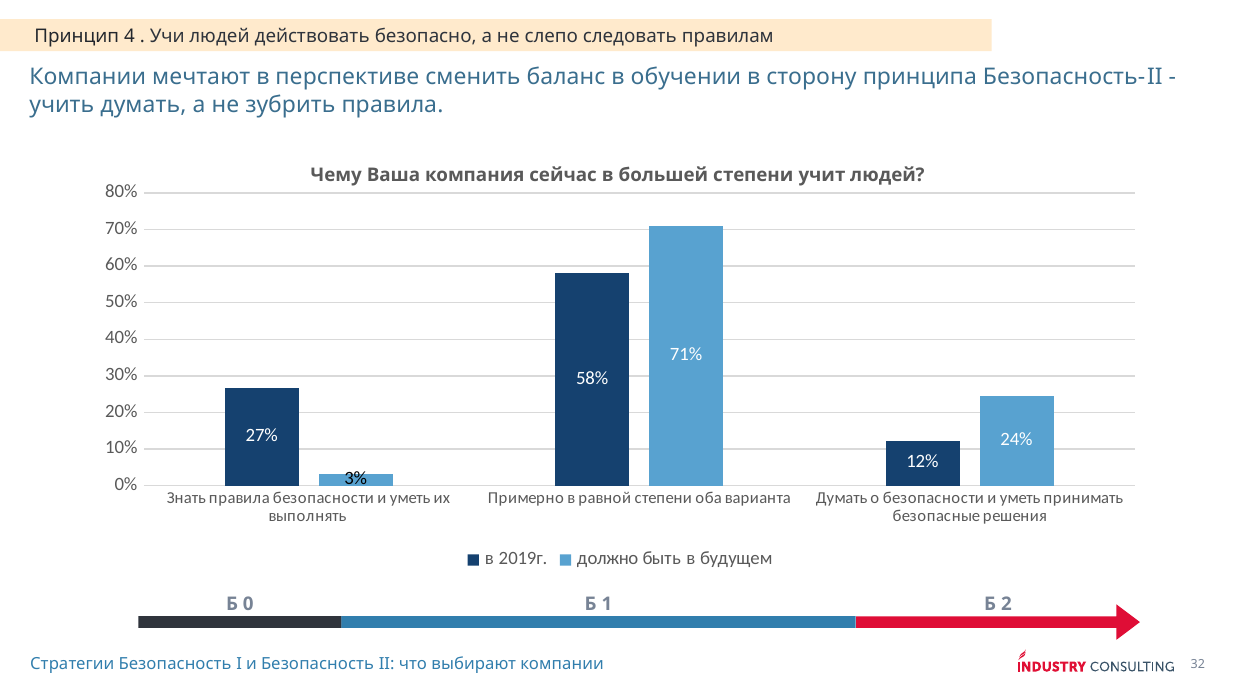
What is the value for 'Знать правила безопасности и уметь их выполнять' in the 'в 2019г.' series? 27% What is the value for 'Знать правила безопасности и уметь их выполнять' in the 'должно быть в будущем' series? 3% How many categories are shown on the x axis? 3 What is the title of the chart? Чему Ваша компания сейчас в большей степени учит людей? What is the value for 'Думать о безопасности и уметь принимать безопасные решения' in the 'в 2019г.' series? 12% What kind of chart is shown on the slide? Bar chart Which category has the lowest value in the 'должно быть в будущем' series? Знать правила безопасности и уметь их выполнять What is the value for 'Примерно в равной степени оба варианта' in the 'должно быть в будущем' series? 71% How many series does the legend list? 2 For 'Знать правила безопасности и уметь их выполнять', which series has the larger value: 'в 2019г.' or 'должно быть в будущем'? в 2019г. Which category has the highest value in the 'в 2019г.' series? Примерно в равной степени оба варианта What is the difference between the 'должно быть в будущем' and 'в 2019г.' values for 'Думать о безопасности и уметь принимать безопасные решения'? 12%